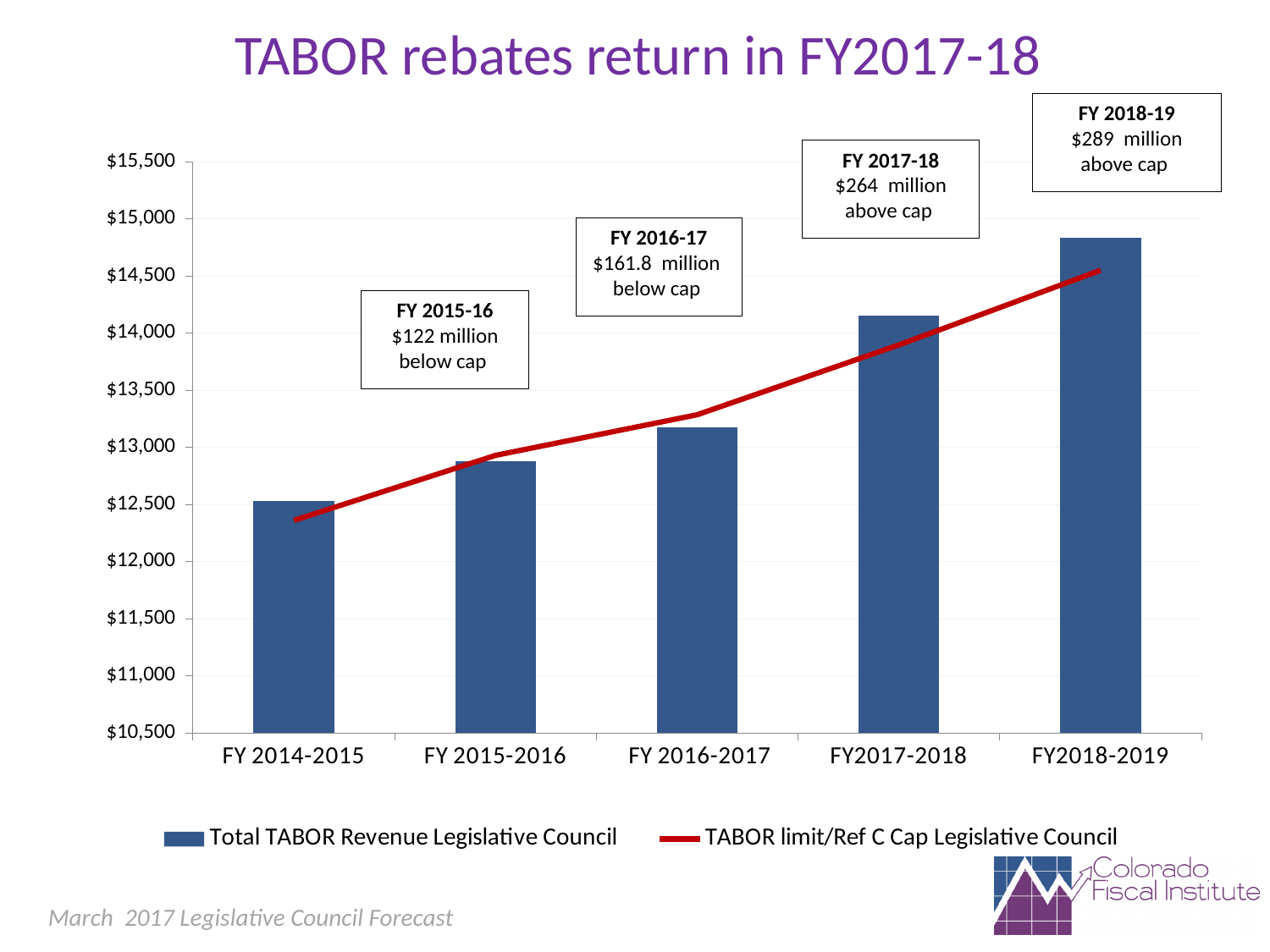
What kind of chart is shown on the slide? bar chart with a line What colour is the TABOR limit/Ref C Cap Legislative Council line? red Do the Total TABOR Revenue bars rise or fall from FY 2014-2015 to FY2018-2019? rise According to the annotation box, how far above the cap is revenue in FY 2017-18? $264 million Is the Total TABOR Revenue bar for FY2017-2018 greater or less than $14,000? greater Which fiscal year has the highest Total TABOR Revenue bar? FY2018-2019 Is the Total TABOR Revenue bar for FY 2016-2017 greater or less than $13,500? less How many series does the legend list? 2 How many fiscal years are shown on the x axis? 5 Which fiscal year has the lowest Total TABOR Revenue bar? FY 2014-2015 Is the Total TABOR Revenue bar for FY 2014-2015 greater or less than $12,000? greater In FY2018-2019, which is larger: the Total TABOR Revenue bar or the TABOR limit/Ref C Cap line? Total TABOR Revenue bar